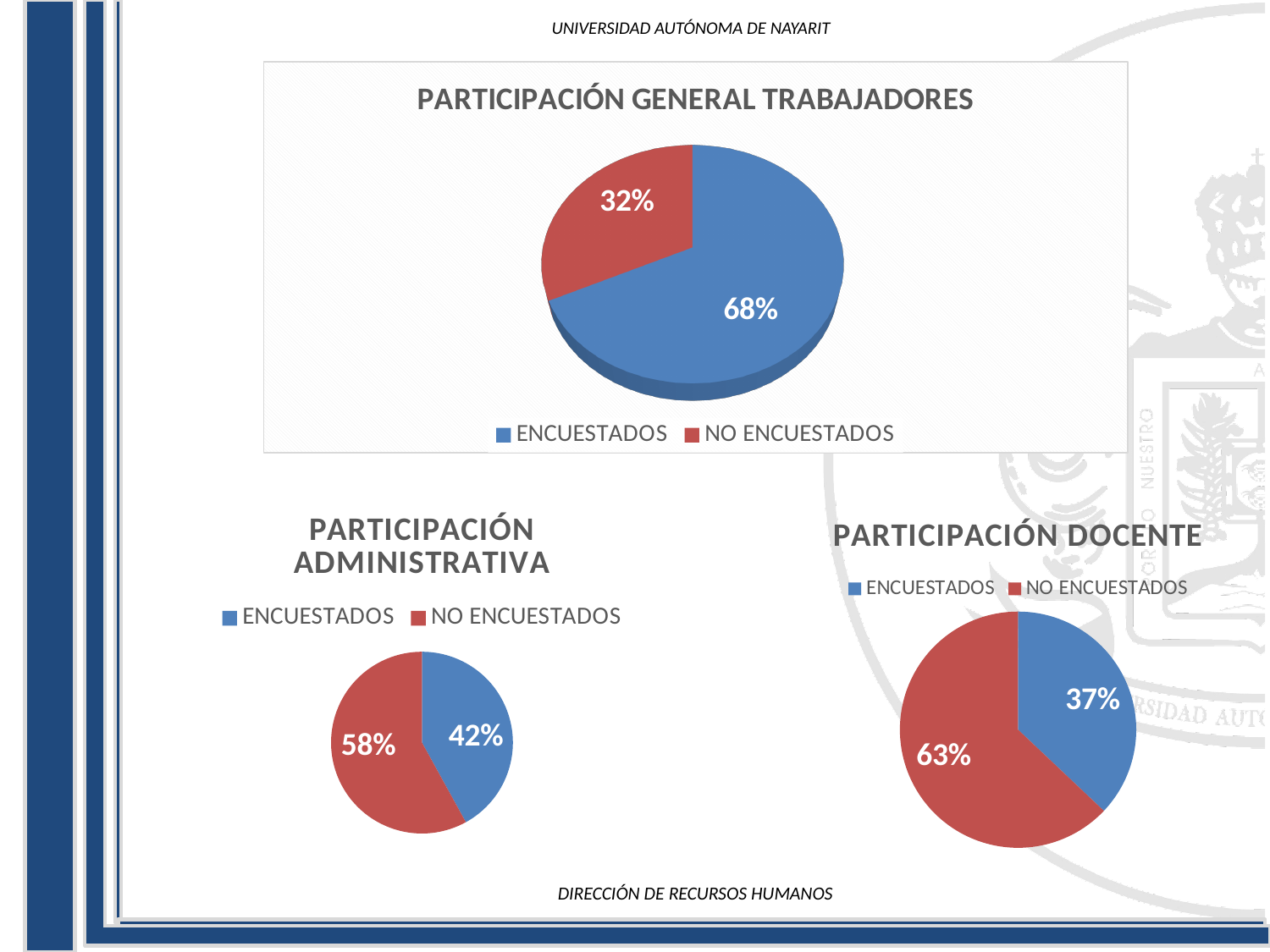
In the PARTICIPACIÓN DOCENTE chart, which slice is the smallest? ENCUESTADOS In the PARTICIPACIÓN DOCENTE chart, what share of the pie is NO ENCUESTADOS? 63% In the PARTICIPACIÓN GENERAL TRABAJADORES chart, which slice is the largest? ENCUESTADOS In the PARTICIPACIÓN ADMINISTRATIVA chart, which is larger, ENCUESTADOS or NO ENCUESTADOS? NO ENCUESTADOS In the PARTICIPACIÓN ADMINISTRATIVA chart, what share of the pie is NO ENCUESTADOS? 58% In the PARTICIPACIÓN GENERAL TRABAJADORES chart, what share of the pie is ENCUESTADOS? 68% In the PARTICIPACIÓN GENERAL TRABAJADORES chart, what is the difference in percentage points between ENCUESTADOS and NO ENCUESTADOS? 36 How many entries does the legend of the PARTICIPACIÓN ADMINISTRATIVA chart list? 2 What kind of chart is the PARTICIPACIÓN DOCENTE chart? Pie chart